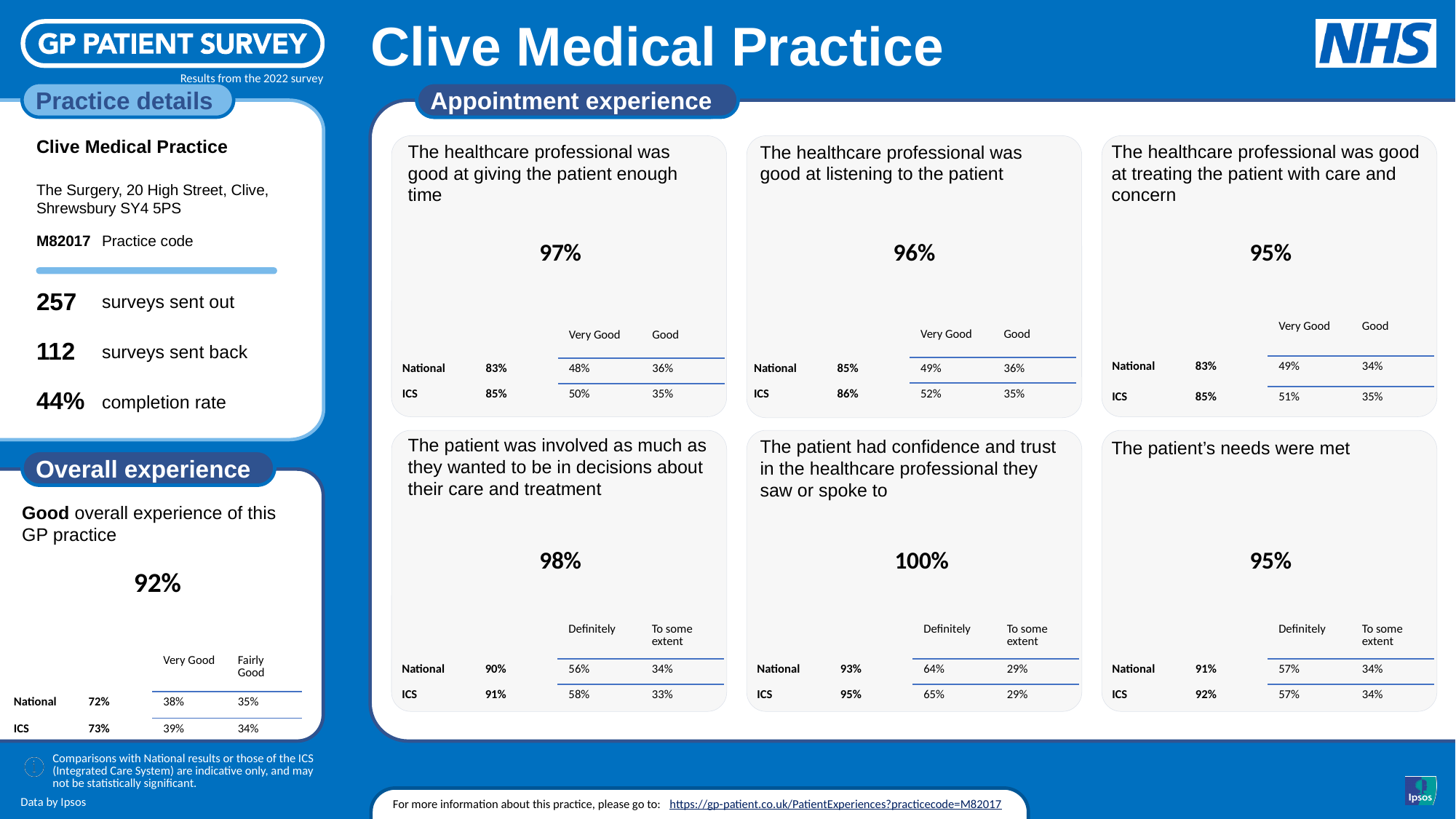
In the panel 'The healthcare professional was good at giving the patient enough time', what is the practice's value? 97% In the 'Overall experience' panel, what are the two response categories listed in the comparison table? Very Good and Fairly Good In the panel 'The patient had confidence and trust in the healthcare professional they saw or spoke to', what is the ICS 'Definitely' value? 65% Among the six 'Appointment experience' panels, which question has the highest practice value? The patient had confidence and trust in the healthcare professional they saw or spoke to In the 'Overall experience' panel, what is the ICS 'Very Good' value? 39% In the panel 'The healthcare professional was good at listening to the patient', what is the ICS value? 86% In the 'Overall experience' panel, what percentage of patients reported a good overall experience of this GP practice? 92% How many question panels are shown under 'Appointment experience'? 6 In the panel 'The healthcare professional was good at treating the patient with care and concern', what is the National 'Good' value? 34% In the panel 'The patient was involved as much as they wanted to be in decisions about their care and treatment', what is the difference between the practice value (98%) and the National value (90%)? 8 percentage points In the 'Overall experience' panel, what is the National value for good overall experience? 72% In the panel 'The patient's needs were met', which is larger: the National value or the ICS value? ICS